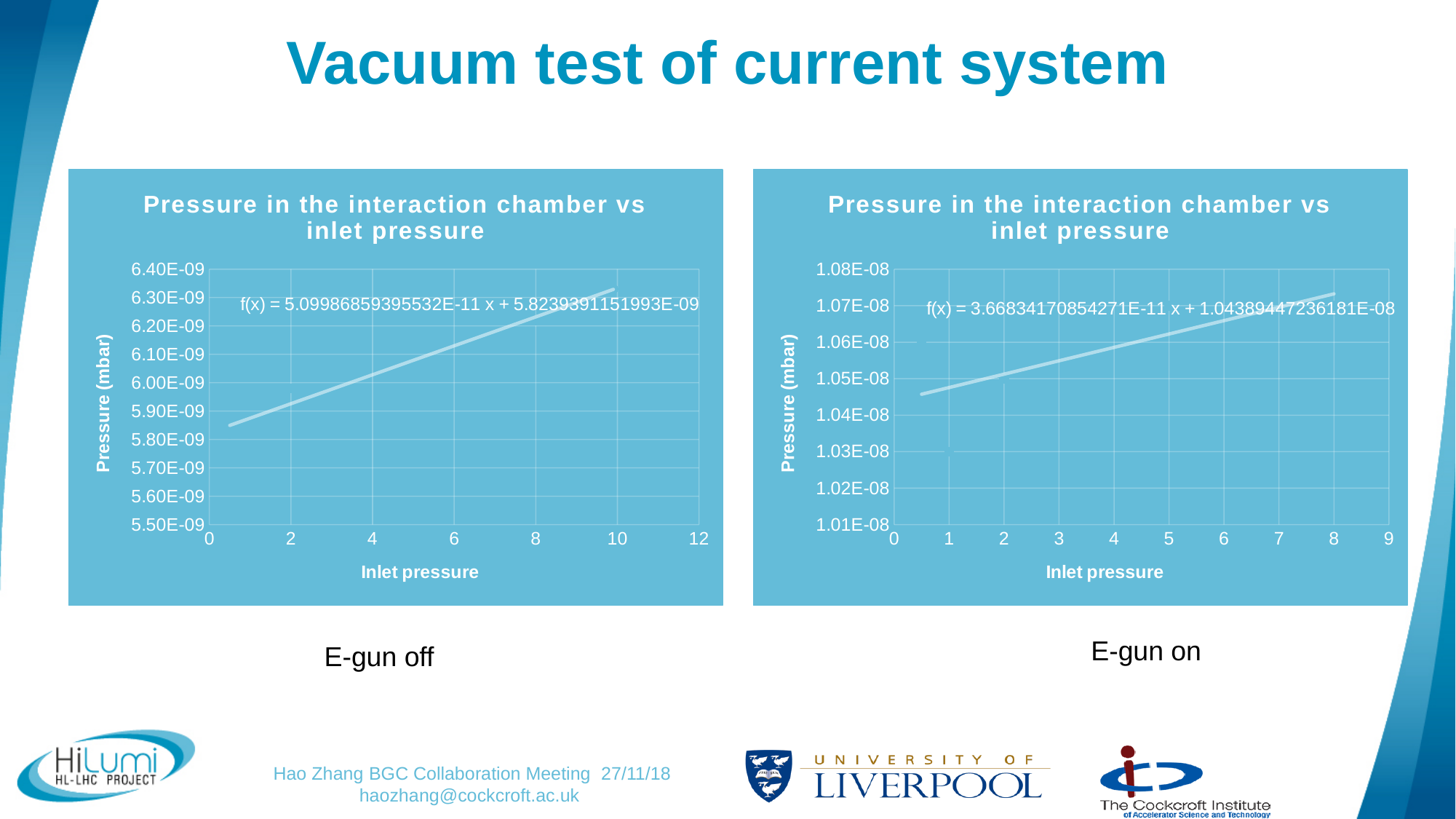
In the left chart (E-gun off), is the pressure at an inlet pressure of 6 greater or less than 6.00E-09? greater In the left chart (E-gun off), does the pressure rise or fall as inlet pressure increases? rise What is the y-axis title of the right chart (E-gun on)? Pressure (mbar) In the right chart (E-gun on), is the pressure at an inlet pressure of 7 greater or less than 1.06E-08? greater In the right chart (E-gun on), is the pressure at an inlet pressure of 1 greater or less than 1.06E-08? less What kind of chart is the left chart (E-gun off)? line chart In the left chart (E-gun off), is the pressure at an inlet pressure of 9 greater or less than the pressure at an inlet pressure of 3? greater In the right chart (E-gun on), does the pressure rise or fall as inlet pressure increases? rise What is the title of the left chart? Pressure in the interaction chamber vs inlet pressure